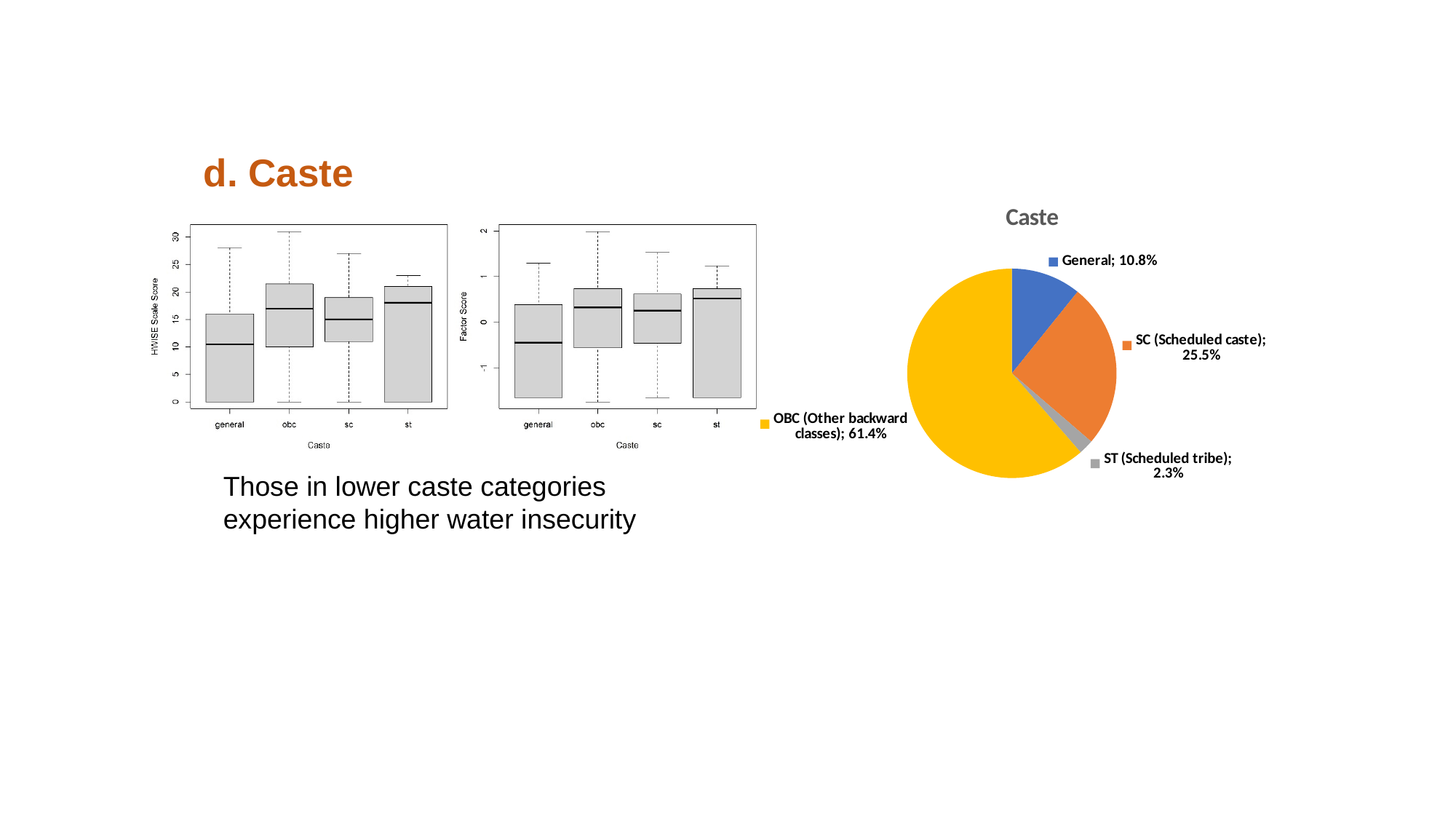
How many slices does the pie chart titled 'Caste' have? 4 In the pie chart titled 'Caste', which category has the smallest slice? ST (Scheduled tribe) In the pie chart titled 'Caste', what share is labelled for ST (Scheduled tribe)? 2.3% What kind of chart is the chart titled 'Caste' on the right of the slide? Pie chart In the left box plot (HWISE Scale Score), is the median for the 'obc' group greater or less than 15? greater In the left box plot (HWISE Scale Score), is the median for the 'general' group greater or less than 15? less In the pie chart titled 'Caste', which category has the largest slice? OBC (Other backward classes) In the pie chart titled 'Caste', which is larger, the General slice or the ST (Scheduled tribe) slice? General In the middle box plot (Factor Score), is the median for the 'general' group greater or less than 0? less In the pie chart titled 'Caste', what share is labelled for OBC (Other backward classes)? 61.4% In the pie chart titled 'Caste', what is the difference in percentage points between the SC (Scheduled caste) share and the General share? 14.7 In the pie chart titled 'Caste', what share is labelled for SC (Scheduled caste)? 25.5%